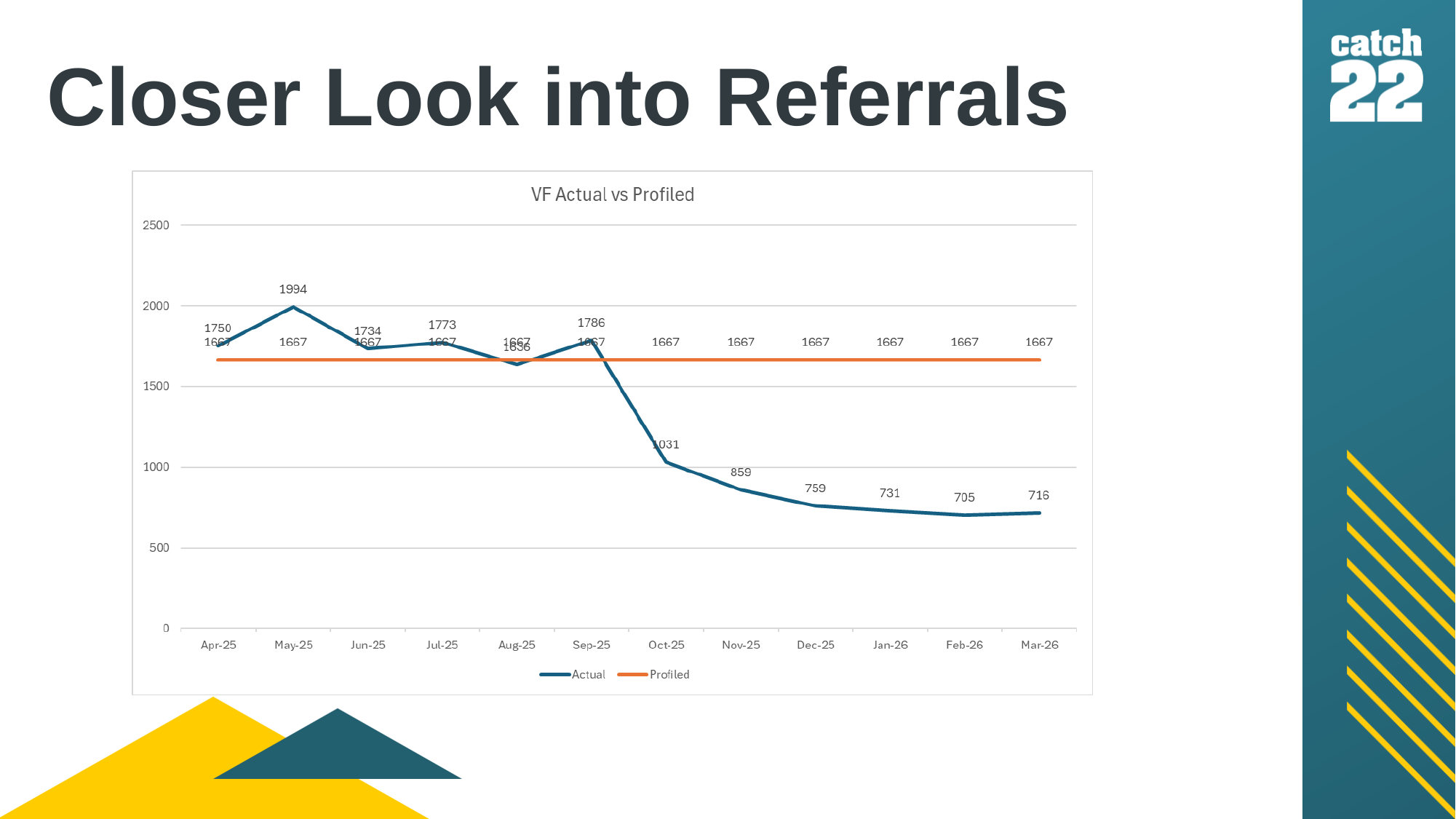
What is the Actual value for May-25? 1994 What kind of chart is shown? line chart What is the difference between the Actual value for Sep-25 and the Actual value for Oct-25? 755 How many series does the legend list? 2 What is the Actual value for Feb-26? 705 Which month has the highest Actual value? May-25 How many months are shown on the x axis? 12 What is the Profiled value for Oct-25? 1667 Is the Actual value for Nov-25 greater or less than 1000? less Which month has the lowest Actual value? Feb-26 Which is larger, the Actual value for Jul-25 or the Actual value for Aug-25? Jul-25 What is the title of the chart? VF Actual vs Profiled